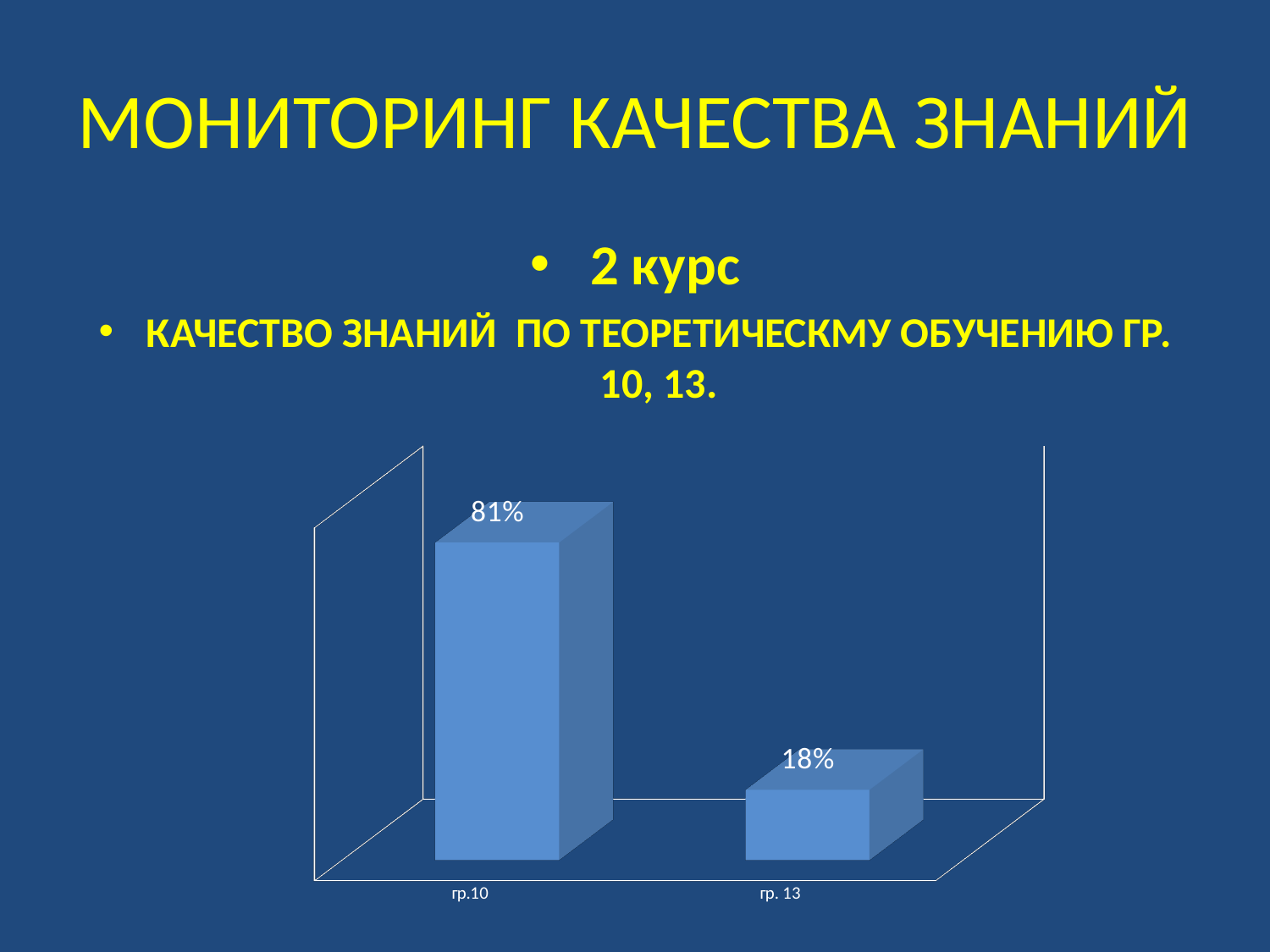
How many categories are shown in the chart? 2 What is the difference between the values for гр.10 and гр. 13? 63% What is the value for гр.10? 81% What is the value for гр. 13? 18% Which is larger, the value for гр.10 or the value for гр. 13? гр.10 Do the values rise or fall from гр.10 to гр. 13? fall What is the total of the two values shown in the chart? 99% What kind of chart is shown on the slide? bar chart Which category has the lowest value? гр. 13 Which category has the highest value? гр.10 What colour are the bars in the chart? blue